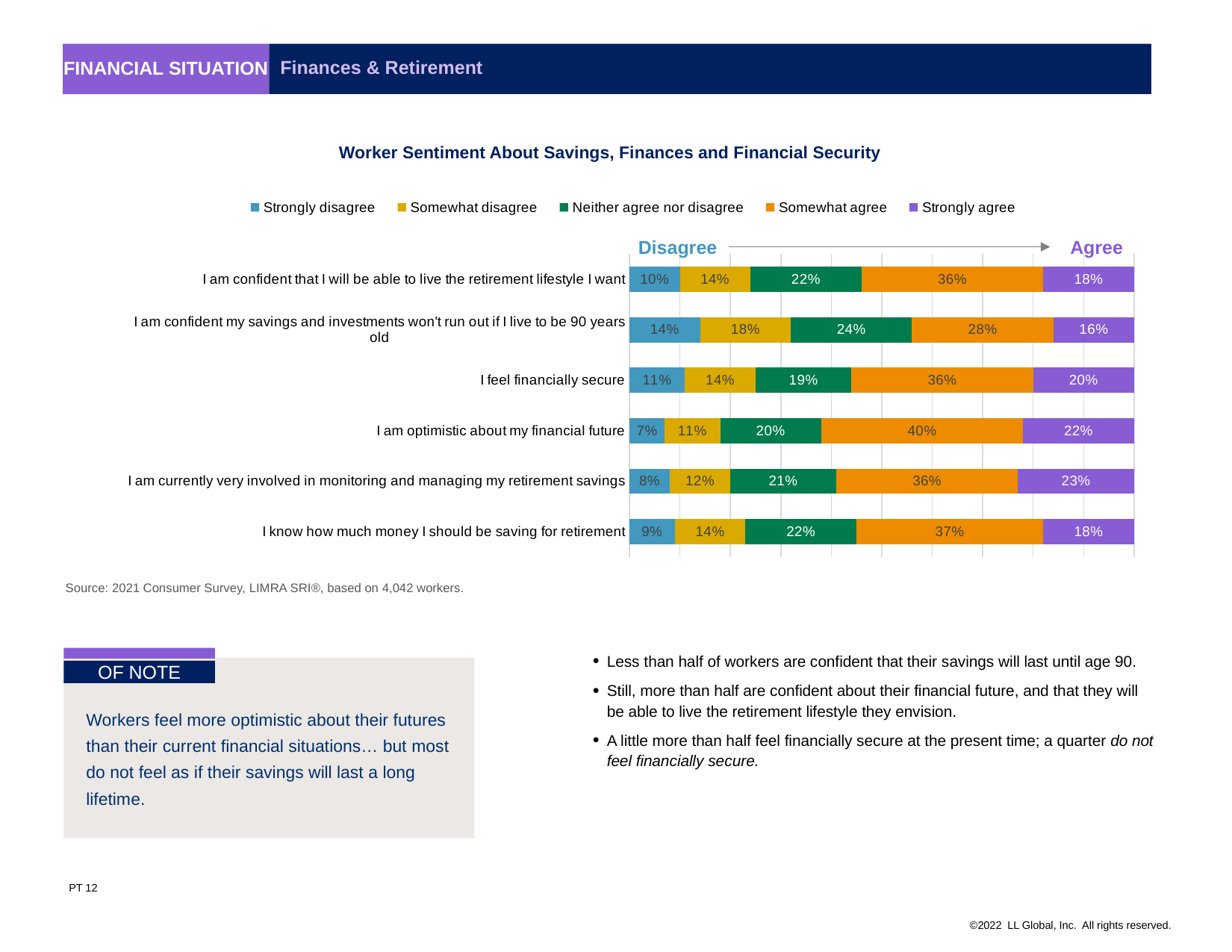
What type of chart is shown on the slide? Stacked bar chart What percentage of workers somewhat agree that they are optimistic about their financial future? 40% What percentage of workers neither agree nor disagree with the statement 'I feel financially secure'? 19% What is the difference between the Somewhat agree percentages for 'I am optimistic about my financial future' and 'I am confident my savings and investments won't run out if I live to be 90 years old'? 12% Which is larger: the Strongly agree share for 'I feel financially secure' or for 'I know how much money I should be saving for retirement'? I feel financially secure What percentage of workers strongly disagree that their savings and investments won't run out if they live to be 90 years old? 14% Which statement has the highest Strongly agree percentage? I am currently very involved in monitoring and managing my retirement savings How many response categories does the legend list? 5 How many statements are shown in the chart? 6 Which statement has the lowest Strongly disagree percentage? I am optimistic about my financial future What is the combined percentage of workers who somewhat agree or strongly agree that they are confident they will be able to live the retirement lifestyle they want? 54% Which response category is shown in purple in the chart? Strongly agree